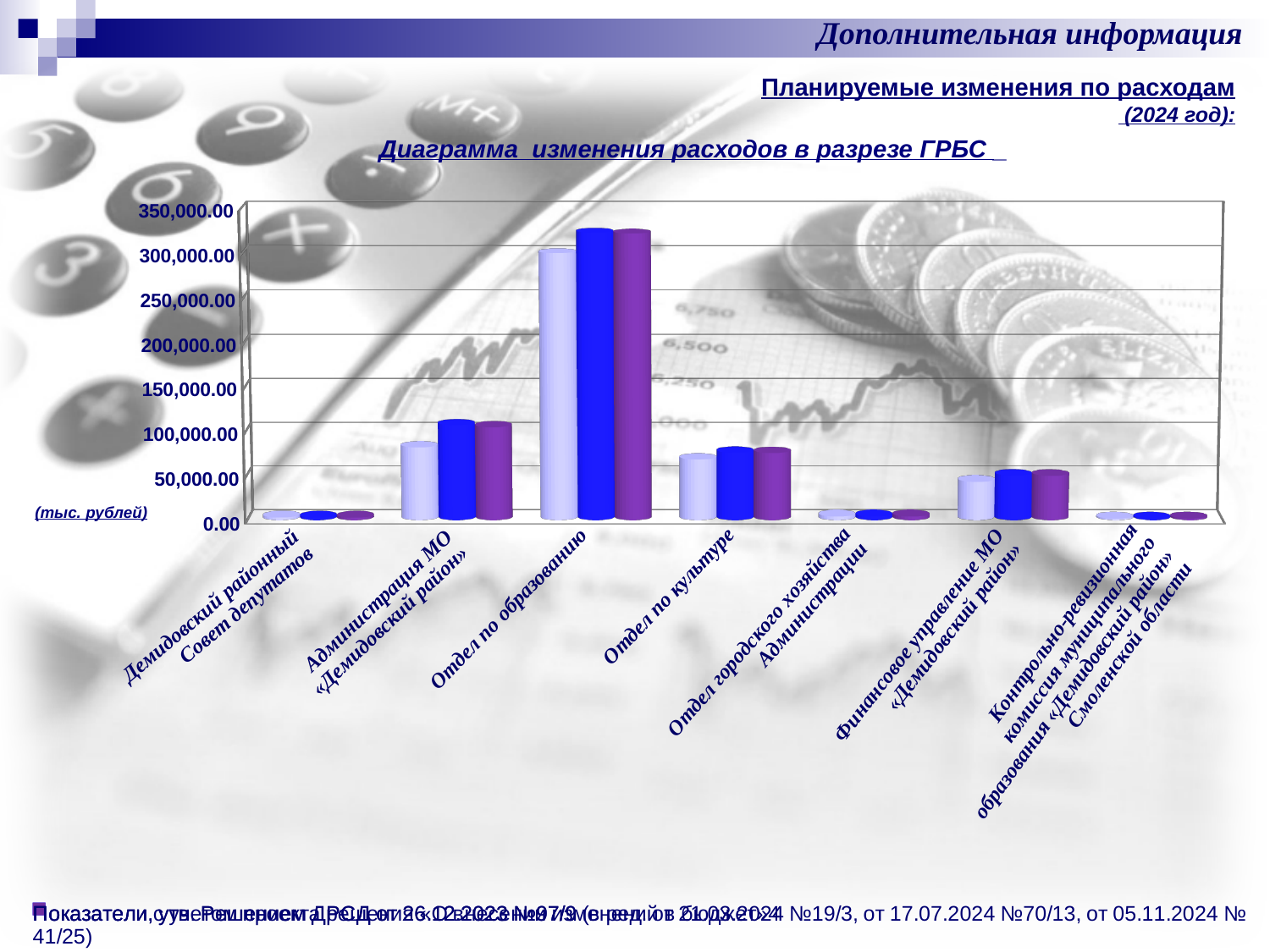
Are the bars for Отдел по образованию greater or less than 250,000.00? greater Which category has larger bars: Администрация МО «Демидовский район» or Отдел по культуре? Администрация МО «Демидовский район» Are the bars for Финансовое управление МО «Демидовский район» greater or less than 100,000.00? less Are the bars for Отдел по культуре greater or less than 100,000.00? less In what units are the values on the chart's vertical axis expressed, according to the label next to the axis? тыс. рублей Which category has larger bars: Отдел по образованию or Финансовое управление МО «Демидовский район»? Отдел по образованию What is the title of the chart? Диаграмма изменения расходов в разрезе ГРБС What kind of chart is shown on the slide? bar chart Which category has the highest bars in the chart? Отдел по образованию How many categories (ГРБС) are shown along the x axis of the chart? 7